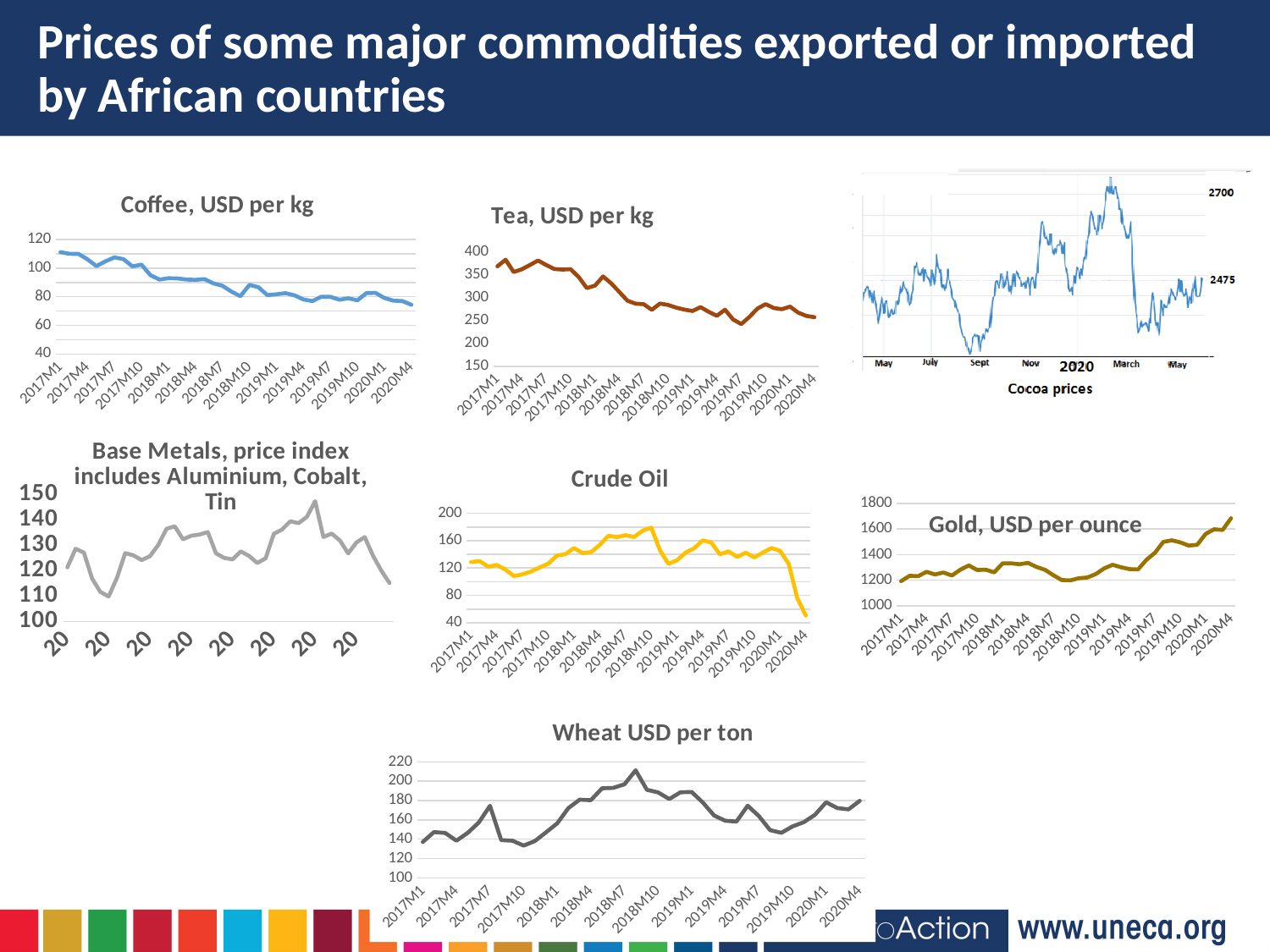
What kind of chart is the Coffee, USD per kg chart? line chart In the Tea, USD per kg chart, is the value for 2017M1 greater or less than 350? greater In the Crude Oil chart, is the value for 2020M4 greater or less than 80? less In the Coffee, USD per kg chart, is the value for 2017M1 greater or less than 100? greater In the Gold, USD per ounce chart, do values generally rise or fall from 2017M1 to 2020M4? rise In the Coffee, USD per kg chart, do values generally rise or fall from 2017M1 to 2020M4? fall In the Cocoa prices chart, what value is labelled at the right end of the line? 2475 In the Tea, USD per kg chart, do values generally rise or fall from 2017M1 to 2020M4? fall How many charts are shown on the slide? 7